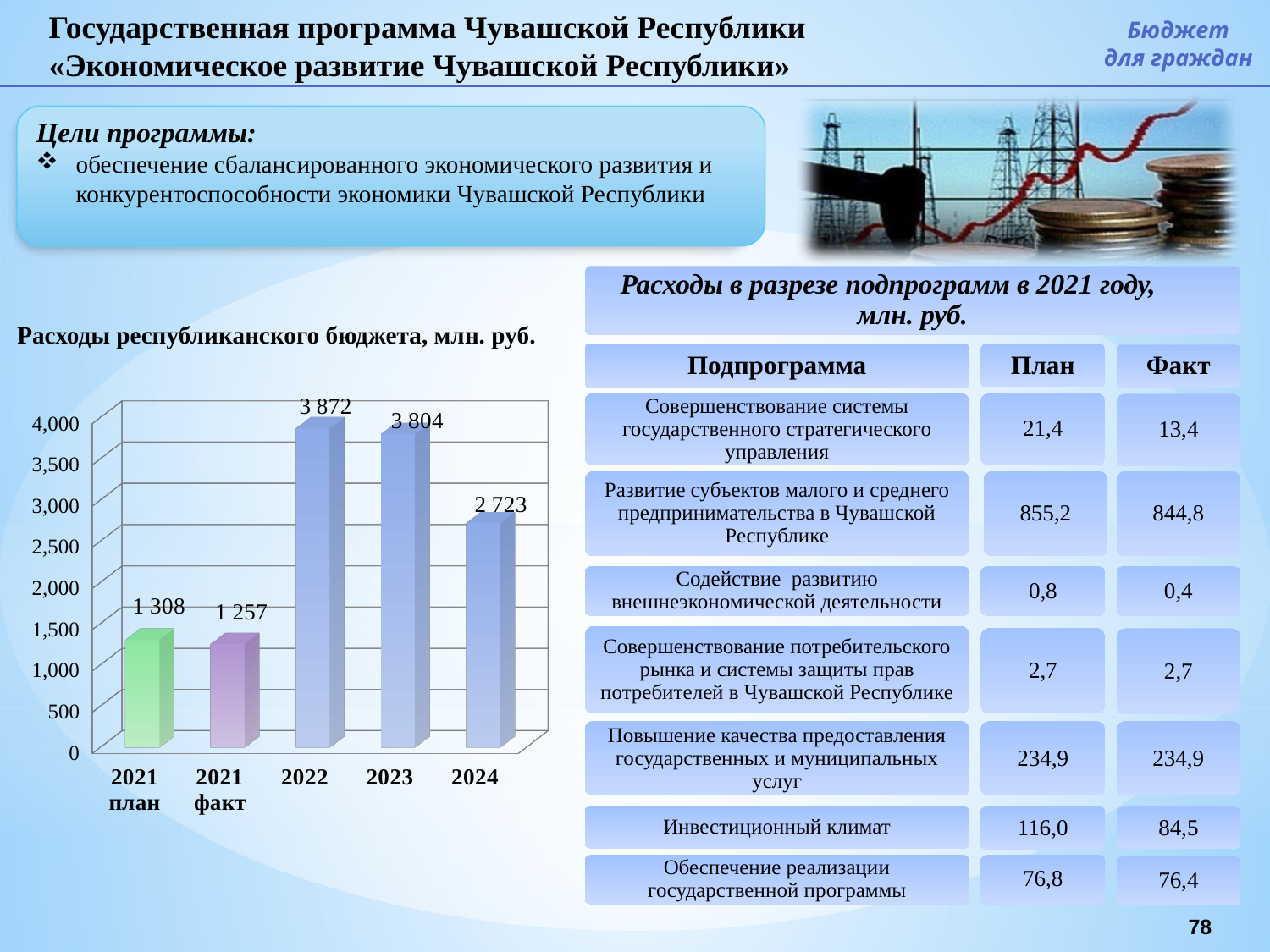
What is the title of the chart on the slide? Расходы республиканского бюджета, млн. руб. What is the value for 2024 in the chart? 2 723 What kind of chart is shown on the slide? bar chart What is the difference between the values for "2021 план" and "2021 факт" in the chart? 51 What is the value for "2021 факт" in the chart? 1 257 Which category has the highest value in the chart? 2022 How many categories are shown on the x axis of the chart? 5 Which is larger in the chart: the value for 2023 or the value for 2024? 2023 Is the value for 2024 in the chart greater or less than 2,500? greater Which category has the lowest value in the chart? 2021 факт What is the difference between the values for 2022 and 2023 in the chart? 68 What is the value for 2022 in the chart "Расходы республиканского бюджета, млн. руб."? 3 872